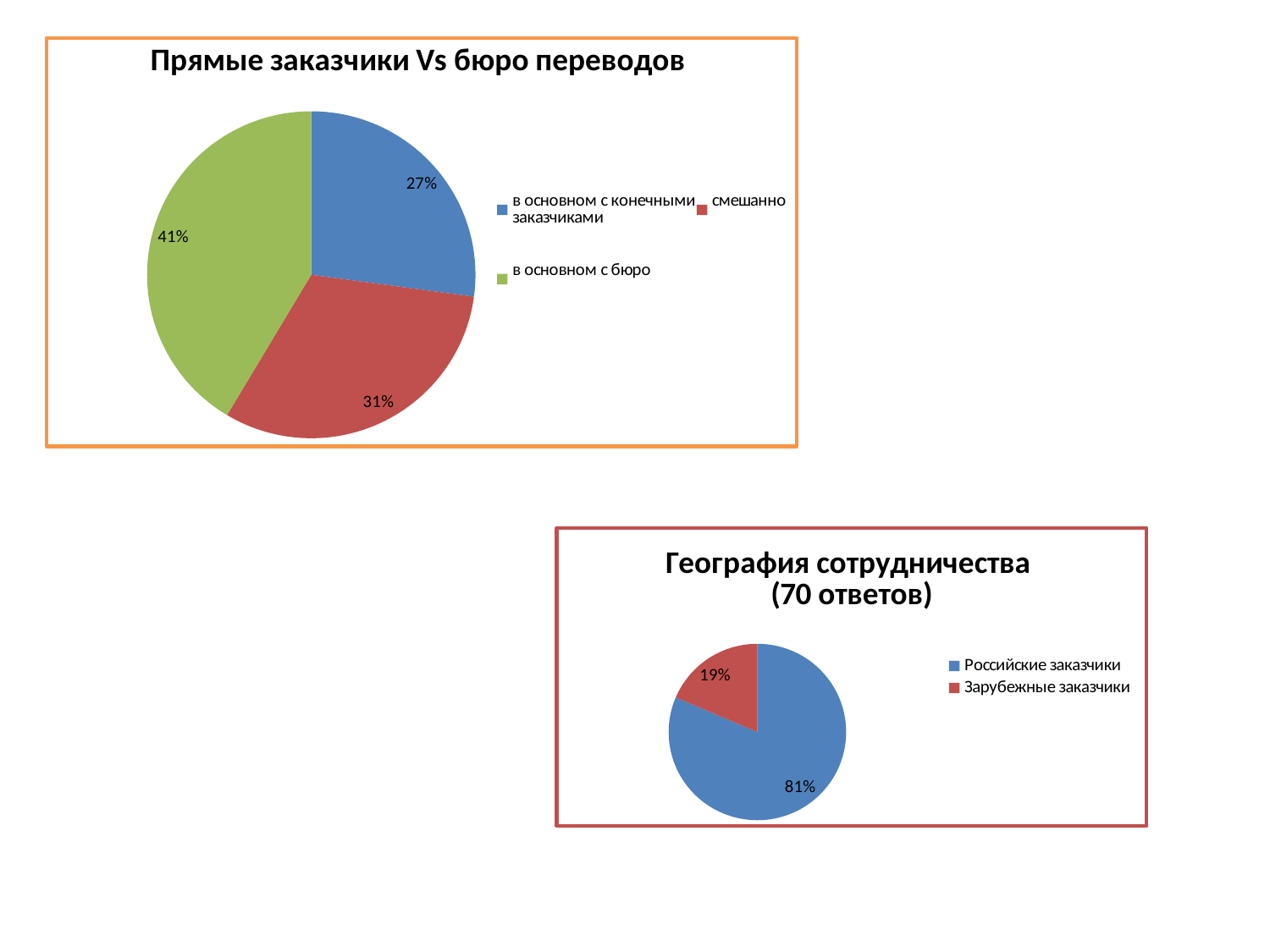
In the chart titled "География сотрудничества (70 ответов)", what share is labelled for "Зарубежные заказчики"? 19% In the chart titled "Прямые заказчики Vs бюро переводов", which category has the smallest slice? в основном с конечными заказчиками In the chart titled "География сотрудничества (70 ответов)", which is larger: "Российские заказчики" or "Зарубежные заказчики"? Российские заказчики What type of chart is the one titled "География сотрудничества (70 ответов)"? pie chart In the chart titled "Прямые заказчики Vs бюро переводов", which category has the largest slice? в основном с бюро In the chart titled "Прямые заказчики Vs бюро переводов", what share is labelled for "смешанно"? 31% In the chart titled "География сотрудничества (70 ответов)", what share is labelled for "Российские заказчики"? 81% In the chart titled "География сотрудничества (70 ответов)", what colour is the slice for "Зарубежные заказчики"? red In the chart titled "Прямые заказчики Vs бюро переводов", how many slices does the pie have? 3 In the chart titled "Прямые заказчики Vs бюро переводов", what share is labelled for "в основном с конечными заказчиками"? 27% In the chart titled "Прямые заказчики Vs бюро переводов", what is the difference in percentage points between "в основном с бюро" and "в основном с конечными заказчиками"? 14 In the chart titled "Прямые заказчики Vs бюро переводов", what share is labelled for "в основном с бюро"? 41%